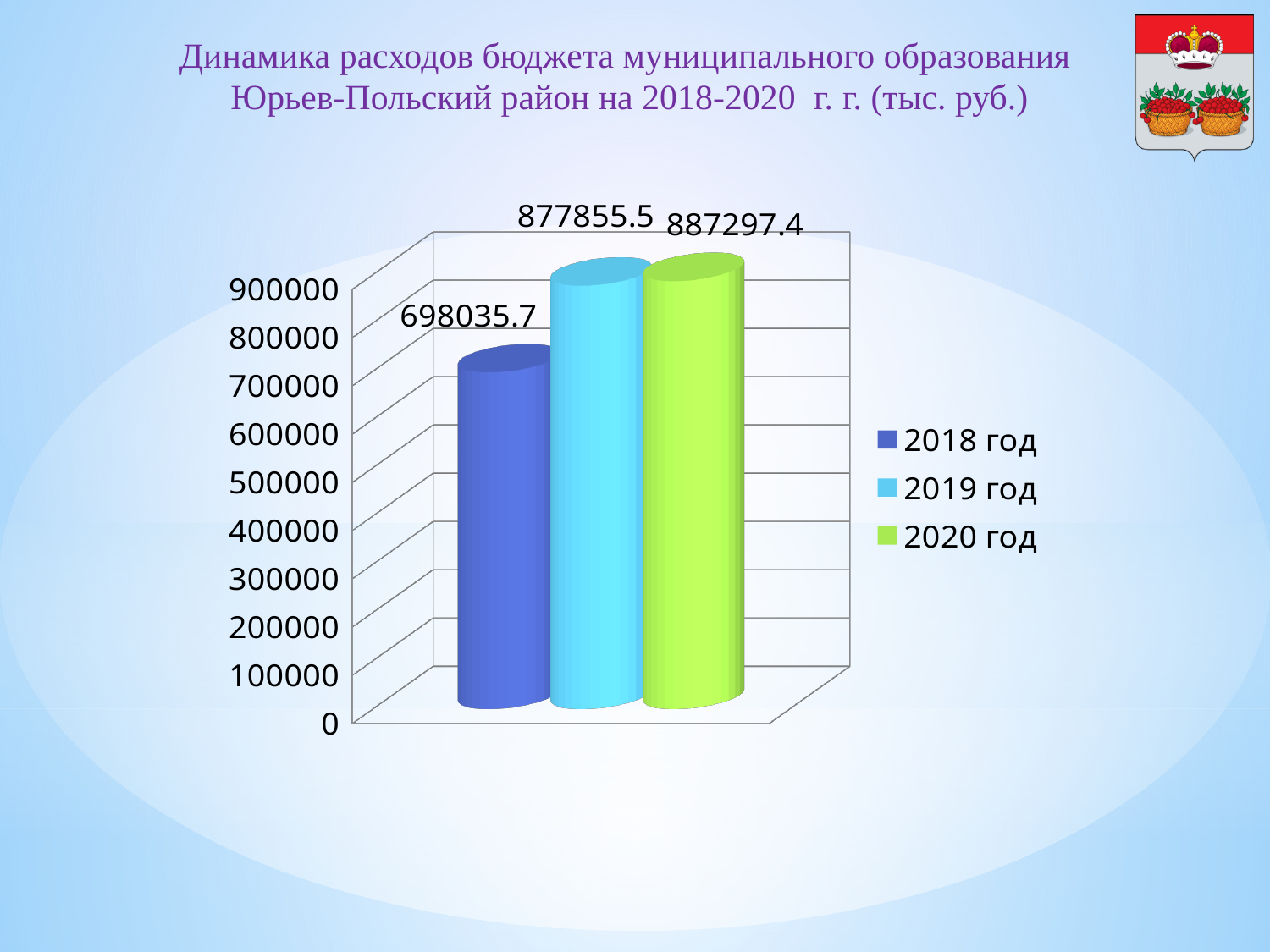
What is the difference between the values for 2019 год and 2018 год? 179819.8 What is the value for 2018 год? 698035.7 Is the value for 2018 год greater or less than 800000? less What kind of chart is shown on the slide? bar chart Which is larger, the value for 2018 год or the value for 2019 год? 2019 год What is the value for 2019 год? 877855.5 How many series does the legend list? 3 Do the values rise or fall from 2018 год to 2020 год? rise What is the value for 2020 год? 887297.4 Which year has the highest value? 2020 год Which year has the lowest value? 2018 год What is the difference between the values for 2020 год and 2019 год? 9441.9